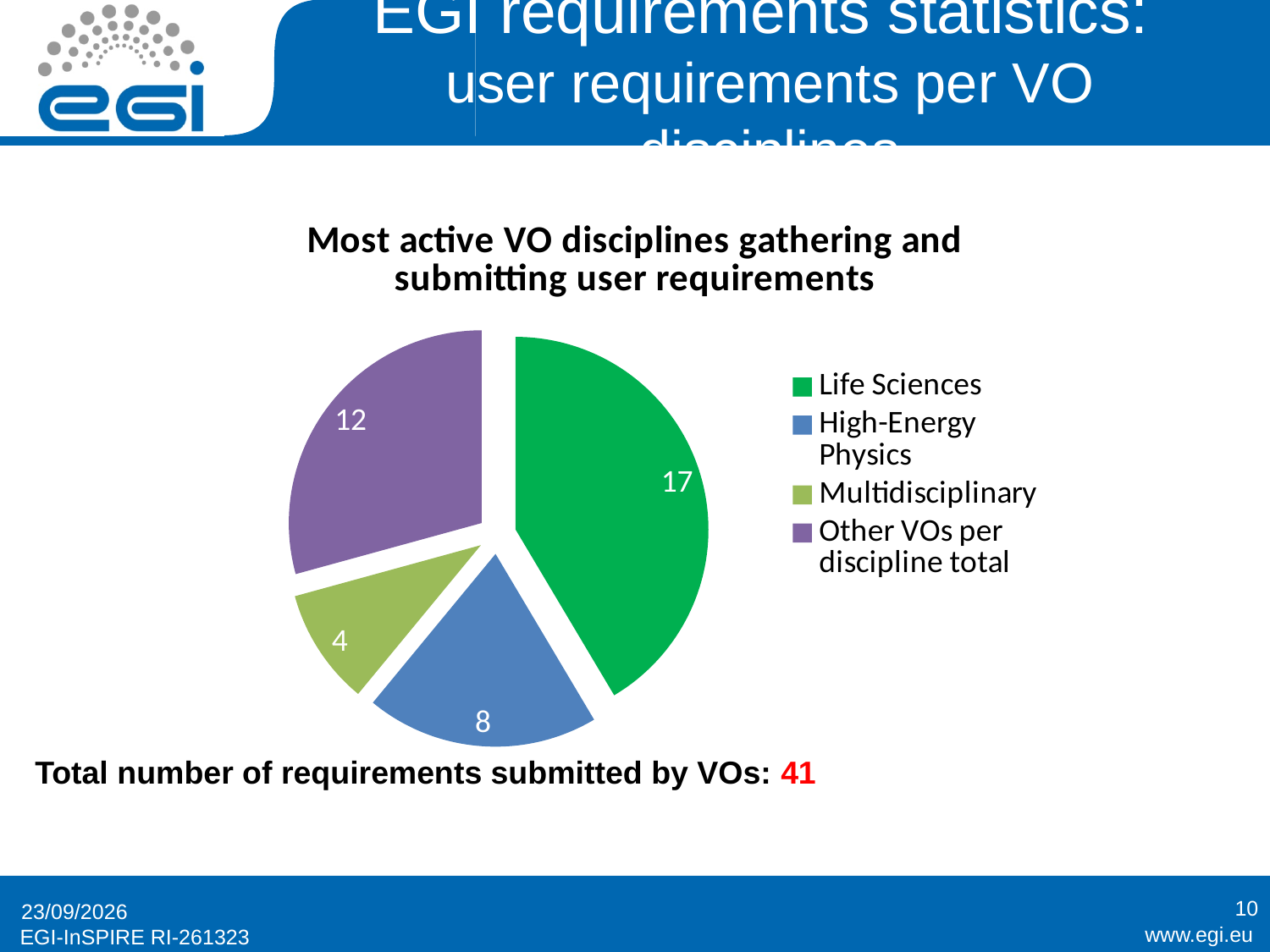
What is the value for Other VOs per discipline total in the pie chart? 12 What is the value for Multidisciplinary in the pie chart? 4 Which discipline has the largest slice of the pie chart? Life Sciences What kind of chart is shown on the slide? pie chart What is the difference between the Life Sciences value and the High-Energy Physics value? 9 Which is larger, the value for High-Energy Physics or the value for Other VOs per discipline total? Other VOs per discipline total How many slices does the pie chart have? 4 What is the value for Life Sciences in the pie chart? 17 What is the value for High-Energy Physics in the pie chart? 8 What is the title of the pie chart? Most active VO disciplines gathering and submitting user requirements What is the total of all the slices in the pie chart? 41 Which discipline has the smallest slice of the pie chart? Multidisciplinary